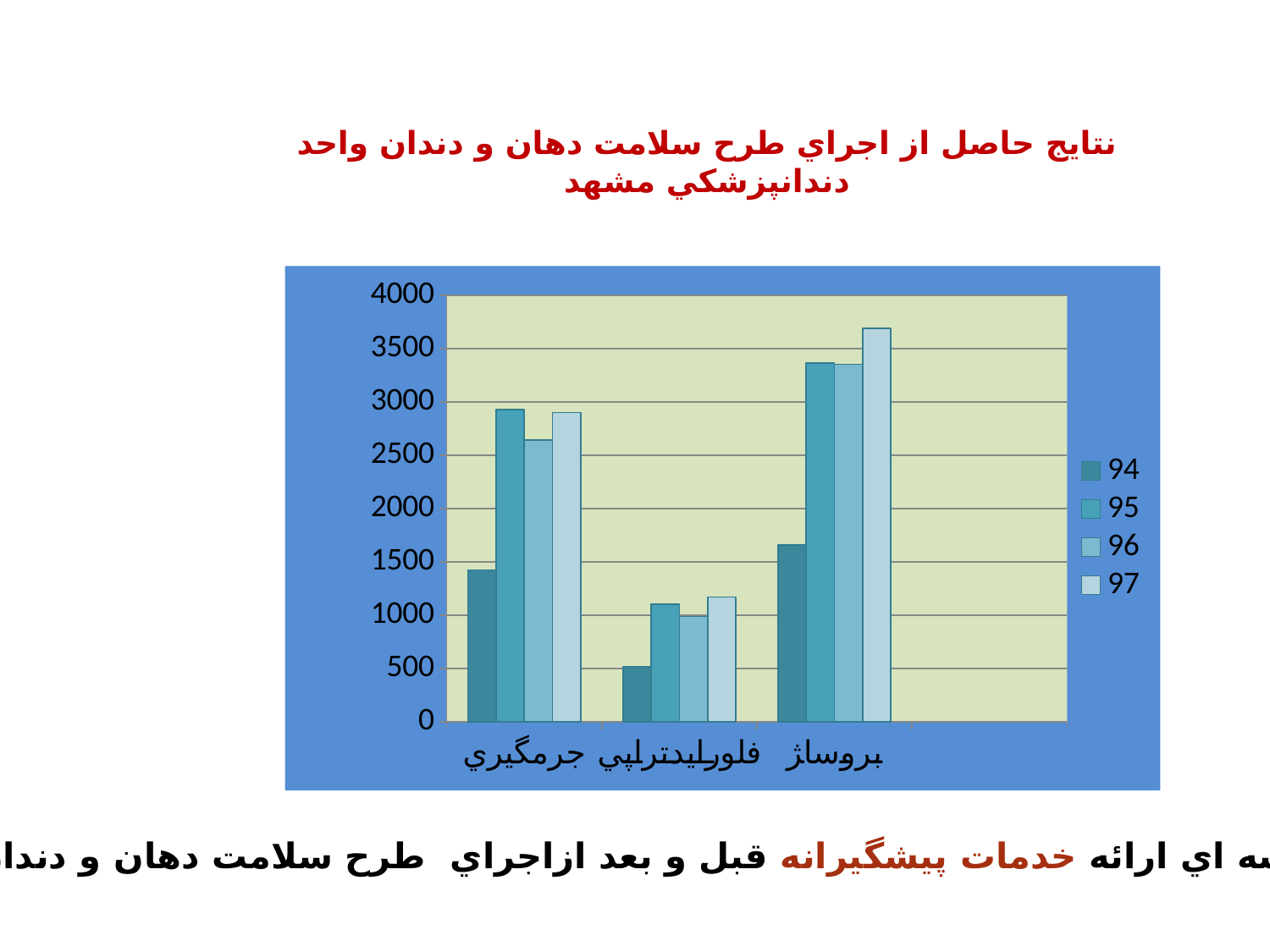
Which category has the lowest values across all series? فلورايدتراپي How many categories are shown on the x axis? 3 What kind of chart is shown on the slide? bar chart In the بروساژ category, which is larger, the value for 94 or the value for 95? 95 Is the value for 95 in the جرمگيري category greater or less than 2500? greater Is the value for 94 in the فلورايدتراپي category greater or less than 1000? less Is the value for 97 in the بروساژ category greater or less than 3500? greater Which category has the highest value for the 97 series? بروساژ How many series does the legend list? 4 Which series are listed in the legend? 94, 95, 96, 97 Which series has the lowest value in the جرمگيري category? 94